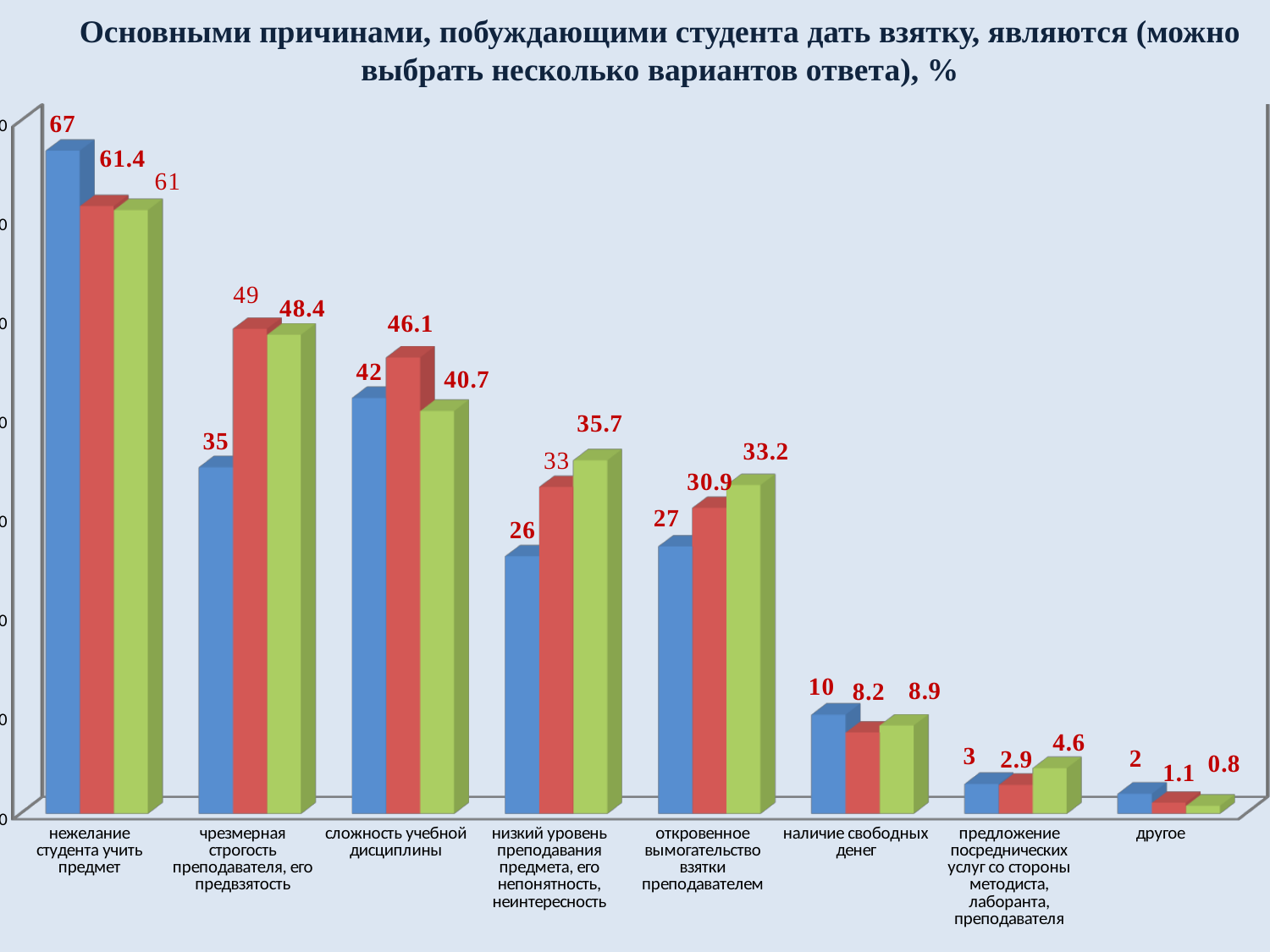
What is the value of the green bar for "низкий уровень преподавания предмета, его непонятность, неинтересность"? 35.7 Which category has the lowest red bar? другое How many bars are shown for each category? 3 Which category has the highest blue bar? нежелание студента учить предмет What is the value of the red bar for "чрезмерная строгость преподавателя, его предвзятость"? 49 What is the value of the blue bar for "нежелание студента учить предмет"? 67 What is the value of the green bar for "другое"? 0.8 What is the difference between the blue and red bars for "чрезмерная строгость преподавателя, его предвзятость"? 14 Which is larger for "сложность учебной дисциплины": the red bar or the green bar? the red bar What type of chart is shown on the slide? bar chart Do the blue bars generally rise or fall from left to right along the x axis? fall How many categories are shown on the x axis? 8